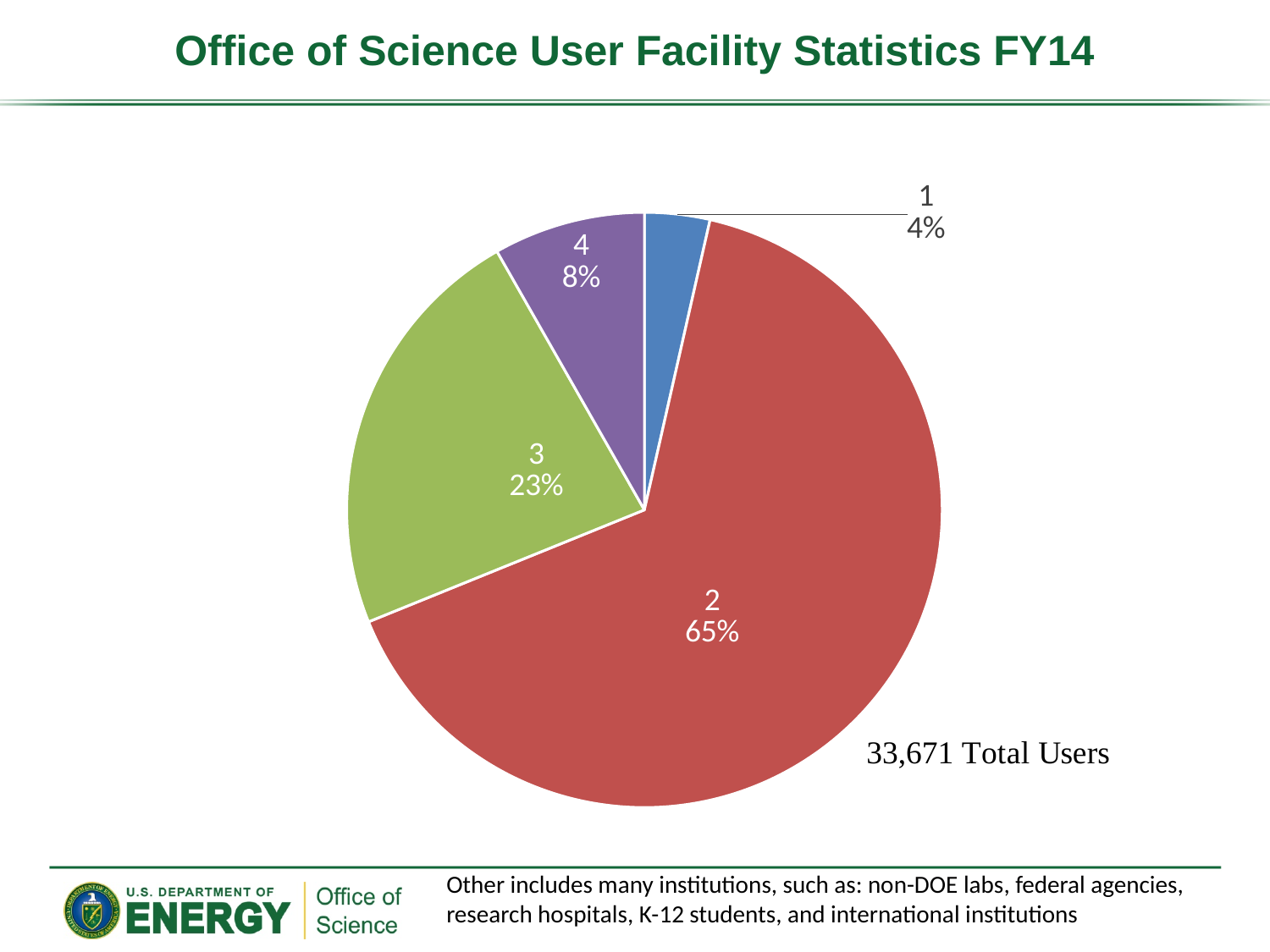
What kind of chart is shown on the slide? pie chart What is the title of the slide containing the pie chart? Office of Science User Facility Statistics FY14 What share of the pie does slice 2 represent? 65% Which slice is larger, slice 3 or slice 4? 3 Which slice of the pie is the largest? 2 How many slices does the pie chart have? 4 What share of the pie does slice 1 represent? 4% Which slice of the pie is the smallest? 1 What is the total number of users stated next to the pie chart? 33,671 What share of the pie does slice 4 represent? 8% What is the difference in percentage points between slice 2 and slice 3? 42